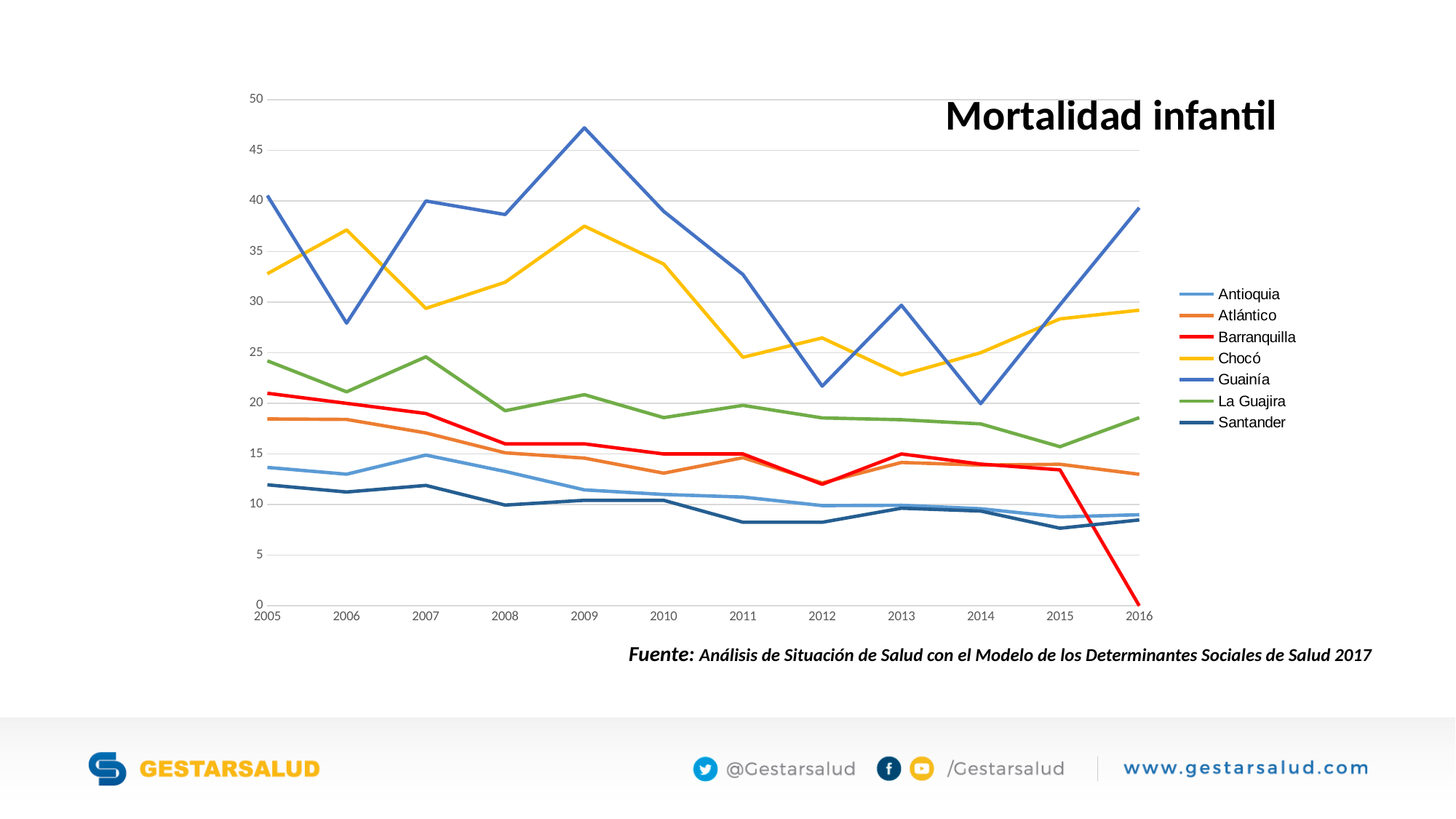
Is the value for Santander in 2015 greater or less than 10? less In 2012, which is larger: the value for Chocó or the value for Guainía? Chocó Is the value for Guainía in 2014 greater or less than 25? less What is the title of the chart? Mortalidad infantil Which series has the lowest value in 2016? Barranquilla How many years are shown along the x axis? 12 Which series has the highest value in 2009? Guainía How many series does the legend list? 7 Does the value for Antioquia rise or fall from 2005 to 2016? fall Is the value for Guainía in 2009 greater or less than 45? greater What kind of chart is shown on the slide? line chart Which series has the highest value in 2006? Chocó